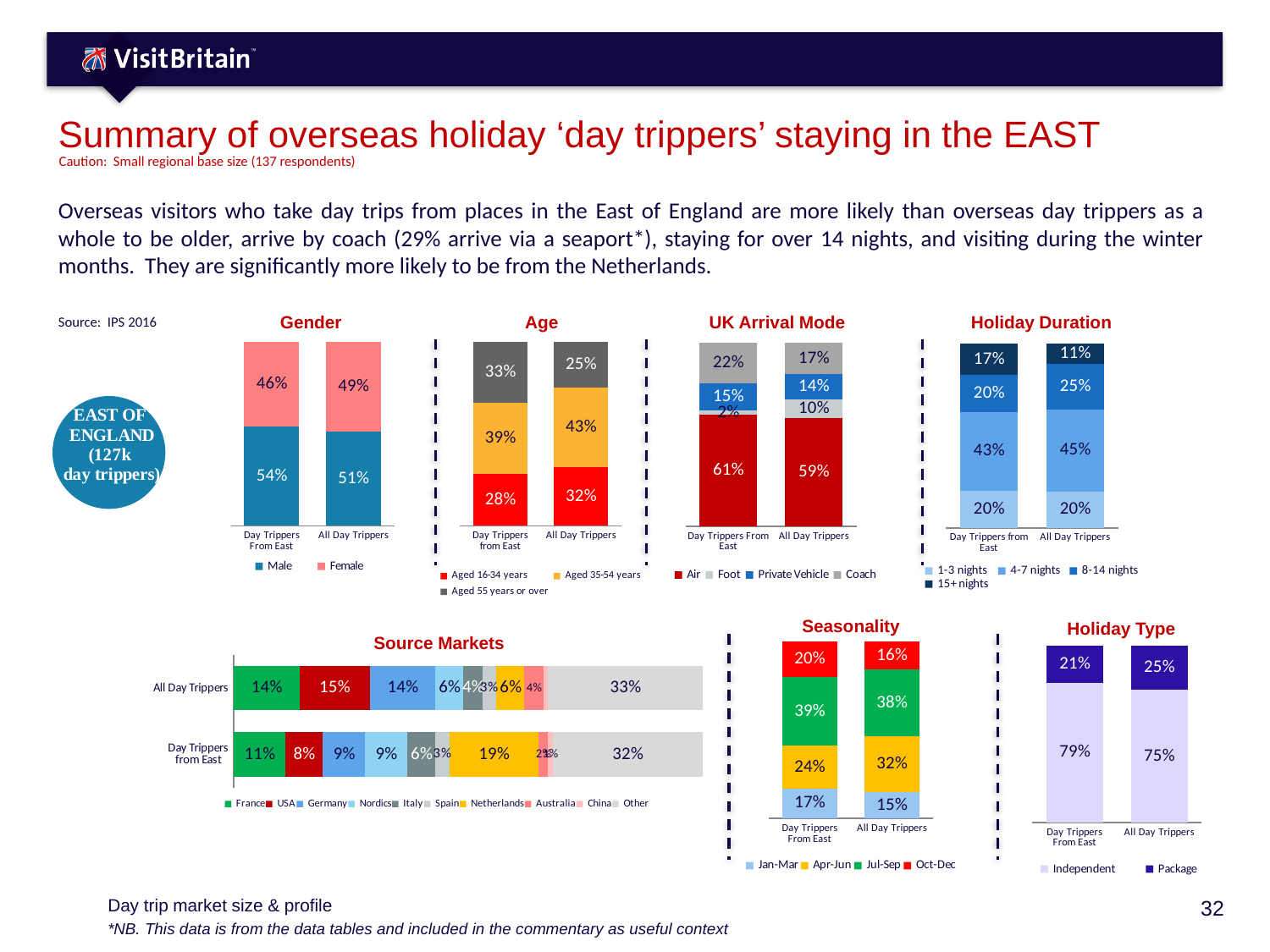
In the Holiday Type chart, what percentage of Day Trippers From East take Package holidays? 21% In the Source Markets chart, how many series does the legend list? 10 In the UK Arrival Mode chart, what percentage of Day Trippers From East arrive by Coach? 22% In the Age chart, what percentage of All Day Trippers are Aged 35-54 years? 43% In the Seasonality chart, what percentage of Day Trippers From East visit in Jul-Sep? 39% In the Gender chart, what percentage of Day Trippers From East are Male? 54% In the Holiday Duration chart, which segment is largest for Day Trippers from East? 4-7 nights In the UK Arrival Mode chart, what is the difference between the Air share for Day Trippers From East and for All Day Trippers? 2% What kind of chart is the Holiday Type chart? Stacked bar chart In the Source Markets chart, what percentage of Day Trippers from East are from the Netherlands? 19% In the Holiday Duration chart, is the 15+ nights share larger for Day Trippers from East or for All Day Trippers? Day Trippers from East In the Seasonality chart, which quarter has the smallest share for All Day Trippers? Jan-Mar